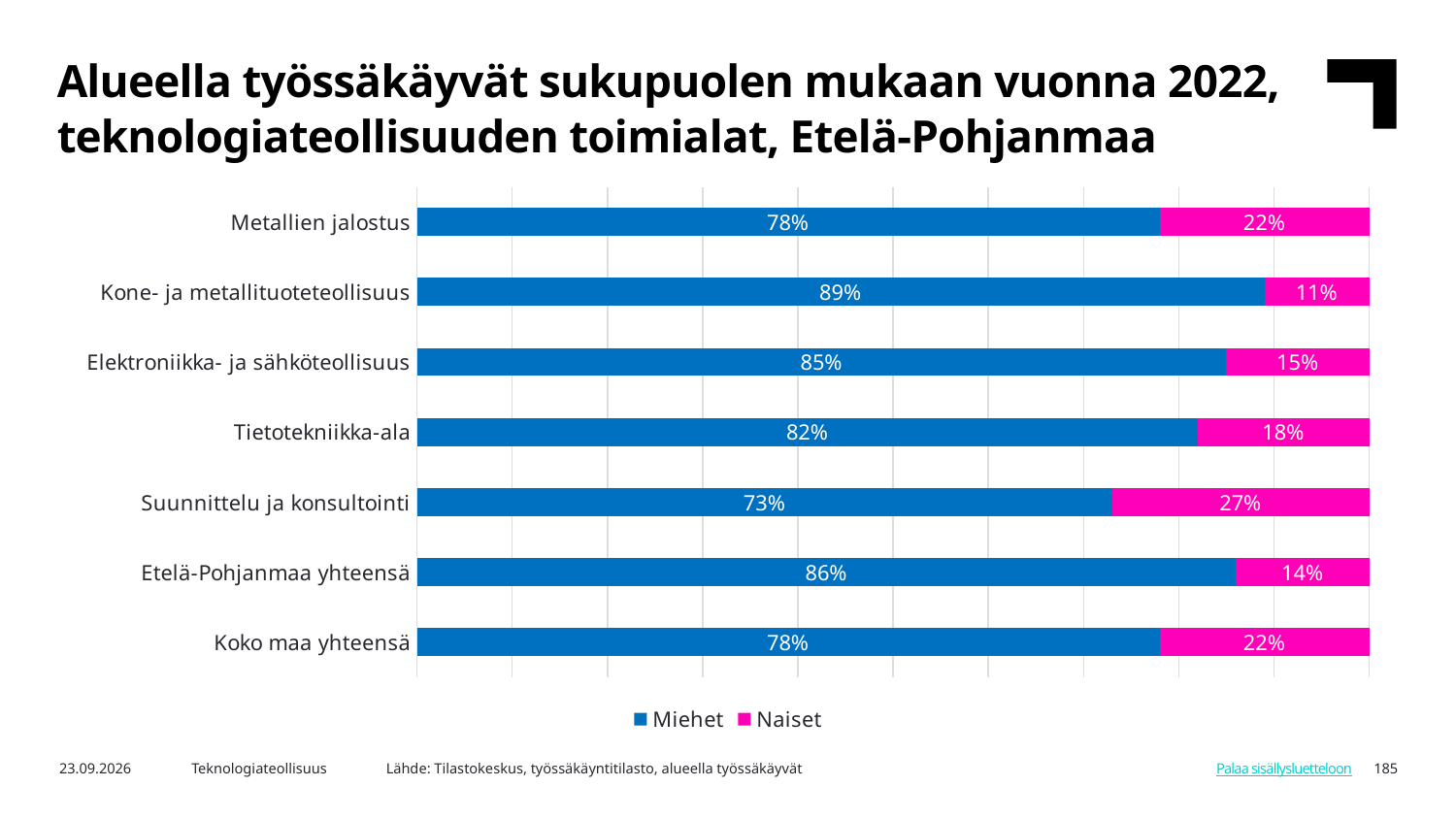
What is the Miehet share for Tietotekniikka-ala? 82% How many series does the legend list? 2 Which category has the lowest Naiset share? Kone- ja metallituoteteollisuus What is the Naiset share for Suunnittelu ja konsultointi? 27% What is the Miehet share for Kone- ja metallituoteteollisuus? 89% Which is larger: the Naiset share for Elektroniikka- ja sähköteollisuus or for Tietotekniikka-ala? Tietotekniikka-ala What are the two series named in the legend? Miehet and Naiset How many categories are shown on the chart? 7 What is the difference between the Miehet share for Kone- ja metallituoteteollisuus and for Suunnittelu ja konsultointi? 16 percentage points What is the Naiset share for Etelä-Pohjanmaa yhteensä? 14% Which category has the highest Naiset share? Suunnittelu ja konsultointi What kind of chart is shown on the slide? Stacked bar chart